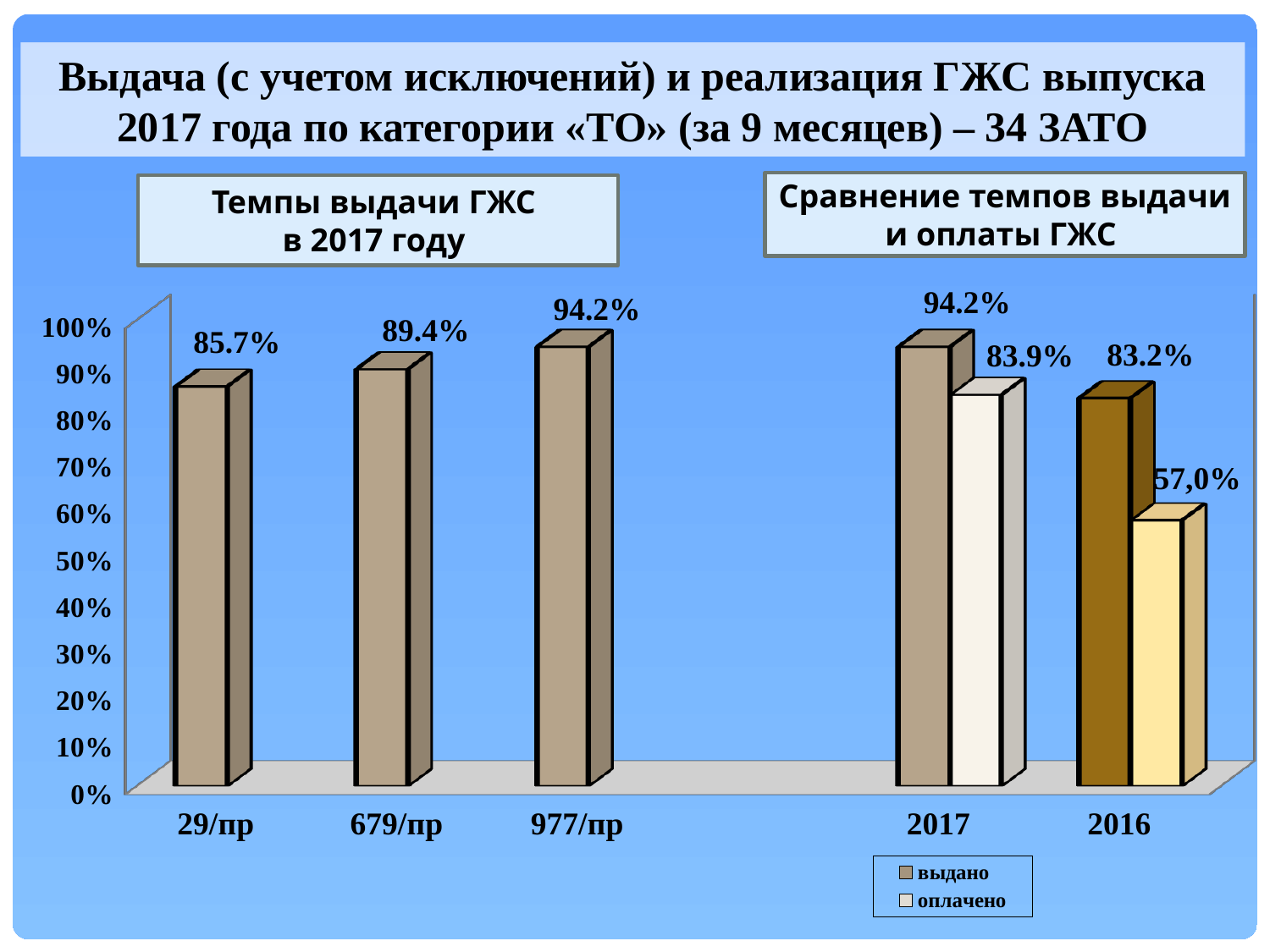
How many series does the legend of the chart "Сравнение темпов выдачи и оплаты ГЖС" list? 2 In the chart "Сравнение темпов выдачи и оплаты ГЖС", what is the value of "выдано" for 2017? 94.2% In the chart "Темпы выдачи ГЖС в 2017 году", do the values rise or fall from 29/пр to 977/пр? rise In the chart "Темпы выдачи ГЖС в 2017 году", what is the difference between the values for 977/пр and 29/пр? 8.5% What kind of chart is "Темпы выдачи ГЖС в 2017 году"? bar chart In the chart "Темпы выдачи ГЖС в 2017 году", which category has the highest value? 977/пр In the chart "Сравнение темпов выдачи и оплаты ГЖС", which is larger: "оплачено" for 2017 or "оплачено" for 2016? оплачено for 2017 In the chart "Темпы выдачи ГЖС в 2017 году", what is the value for 679/пр? 89.4% In the chart "Сравнение темпов выдачи и оплаты ГЖС", what is the difference between "выдано" and "оплачено" for 2017? 10.3% In the chart "Темпы выдачи ГЖС в 2017 году", what is the value for 29/пр? 85.7% In the chart "Темпы выдачи ГЖС в 2017 году", which category has the lowest value? 29/пр In the chart "Сравнение темпов выдачи и оплаты ГЖС", what is the value of "оплачено" for 2016? 57,0%